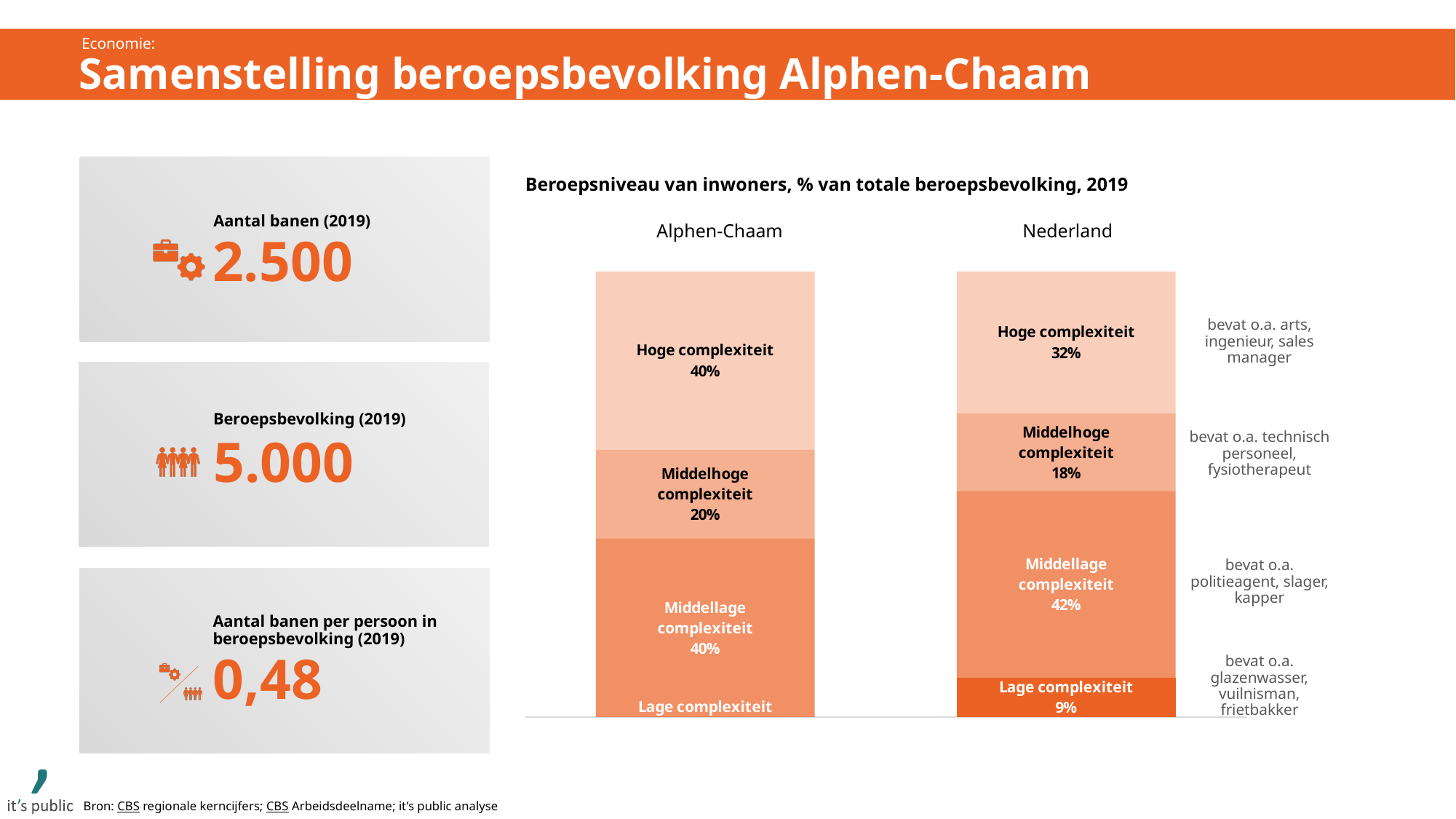
What kind of chart is shown on the slide? Stacked bar chart What is the value for Hoge complexiteit in the Alphen-Chaam bar? 40% What is the title of the chart? Beroepsniveau van inwoners, % van totale beroepsbevolking, 2019 Which segment is the smallest in the Nederland bar? Lage complexiteit Which has a larger Middellage complexiteit share, Alphen-Chaam or Nederland? Nederland How many bars are shown in the chart? 2 What is the value for Lage complexiteit in the Nederland bar? 9% Which segment is the largest in the Nederland bar? Middellage complexiteit What is the difference between the Middelhoge complexiteit share for Alphen-Chaam and for Nederland? 2 percentage points What is the value for Middelhoge complexiteit in the Nederland bar? 18% What is the value for Middellage complexiteit in the Alphen-Chaam bar? 40% What is the difference between the Hoge complexiteit share for Alphen-Chaam and for Nederland? 8 percentage points